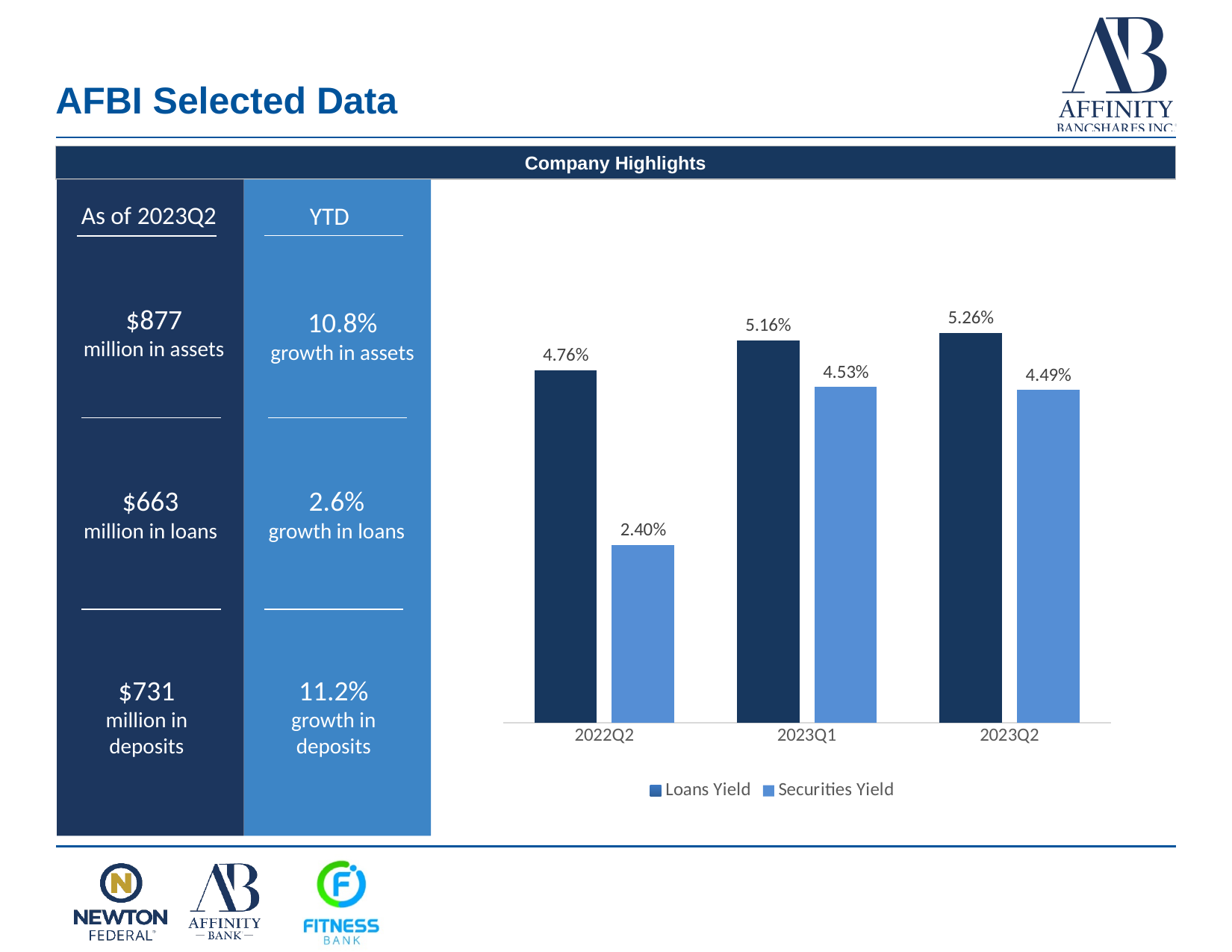
How many series does the chart legend list? 2 What is the Loans Yield for 2023Q1? 5.16% Which period has the lowest Securities Yield? 2022Q2 Which is larger in 2023Q1: the Loans Yield or the Securities Yield? Loans Yield What is the Securities Yield for 2023Q2? 4.49% What is the Loans Yield for 2022Q2? 4.76% Which period has the highest Loans Yield? 2023Q2 What is the difference between the Loans Yield and the Securities Yield in 2022Q2? 2.36% What is the Securities Yield for 2022Q2? 2.40% Does the Loans Yield rise or fall from 2022Q2 to 2023Q2? Rise How many periods are shown on the x axis of the chart? 3 What kind of chart is shown on the slide? Bar chart